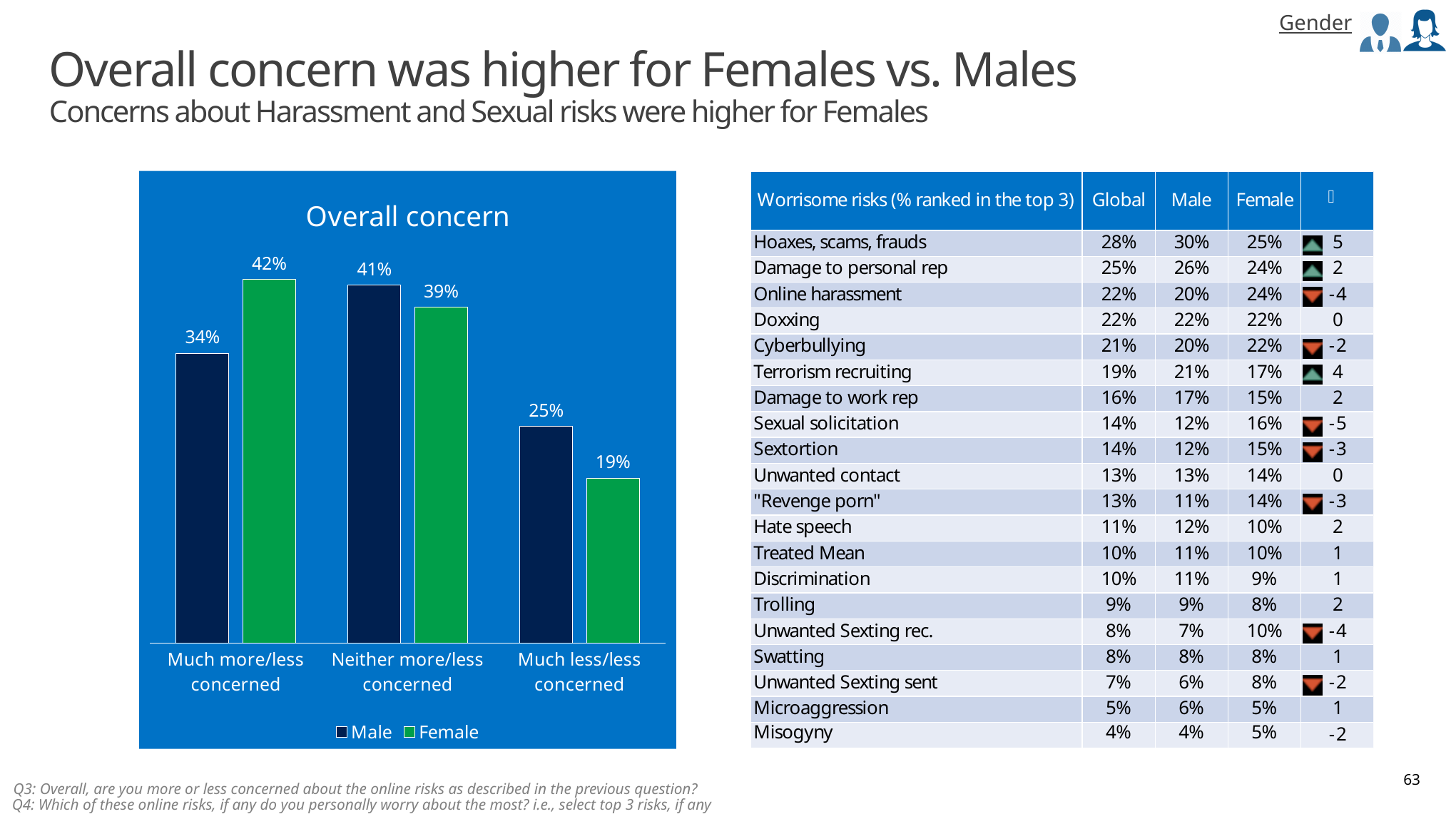
In the Overall concern chart, which category has the lowest Female value? Much less/less concerned In the Overall concern chart, which category has the highest Male value? Neither more/less concerned In the Overall concern chart, what is the difference between the Female and Male values in the 'Much more/less concerned' category? 8% How many series does the legend of the Overall concern chart list? 2 What kind of chart is the Overall concern chart? Bar chart In the Overall concern chart, what is the value for Female in the 'Much more/less concerned' category? 42% In the Overall concern chart, which is larger in the 'Much less/less concerned' category, Male or Female? Male In the Overall concern chart, what is the value for Male in the 'Neither more/less concerned' category? 41% How many categories are shown on the x axis of the Overall concern chart? 3 In the Overall concern chart, what colour are the Female bars? Green In the Overall concern chart, what is the value for Male in the 'Much more/less concerned' category? 34% In the Overall concern chart, what is the value for Female in the 'Much less/less concerned' category? 19%